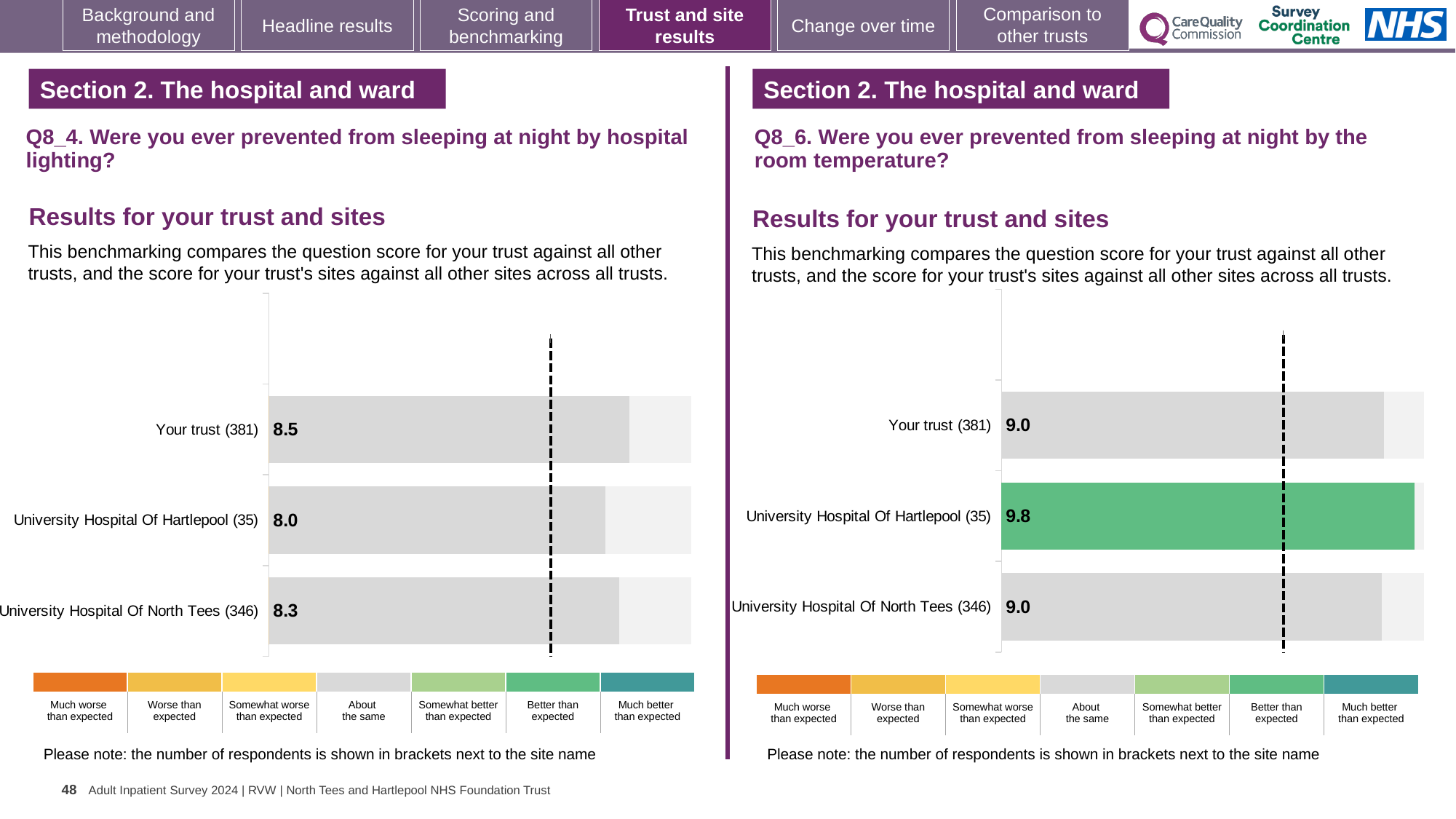
How many rows (bars) are plotted on the Q8_6 chart (room temperature)? 3 On the Q8_4 chart (hospital lighting), what is the difference between the scores for Your trust (381) and University Hospital Of Hartlepool (35)? 0.5 On the Q8_4 chart (hospital lighting), which has the higher score: Your trust (381) or University Hospital Of North Tees (346)? Your trust (381) On the Q8_4 chart (hospital lighting), what is the score for University Hospital Of Hartlepool (35)? 8.0 On the Q8_6 chart (room temperature), which row has the highest score? University Hospital Of Hartlepool (35) On the Q8_4 chart (hospital lighting), what is the score for Your trust (381)? 8.5 On the Q8_6 chart (room temperature), which row's bar is coloured green rather than grey? University Hospital Of Hartlepool (35) On the Q8_6 chart (room temperature), what is the difference between the scores for University Hospital Of Hartlepool (35) and Your trust (381)? 0.8 On the Q8_6 chart (room temperature), what is the score for University Hospital Of North Tees (346)? 9.0 What type of chart is used on the left-hand Q8_4 chart? Bar chart On the Q8_6 chart (room temperature), what is the score for University Hospital Of Hartlepool (35)? 9.8 On the Q8_4 chart (hospital lighting), which row has the lowest score? University Hospital Of Hartlepool (35)